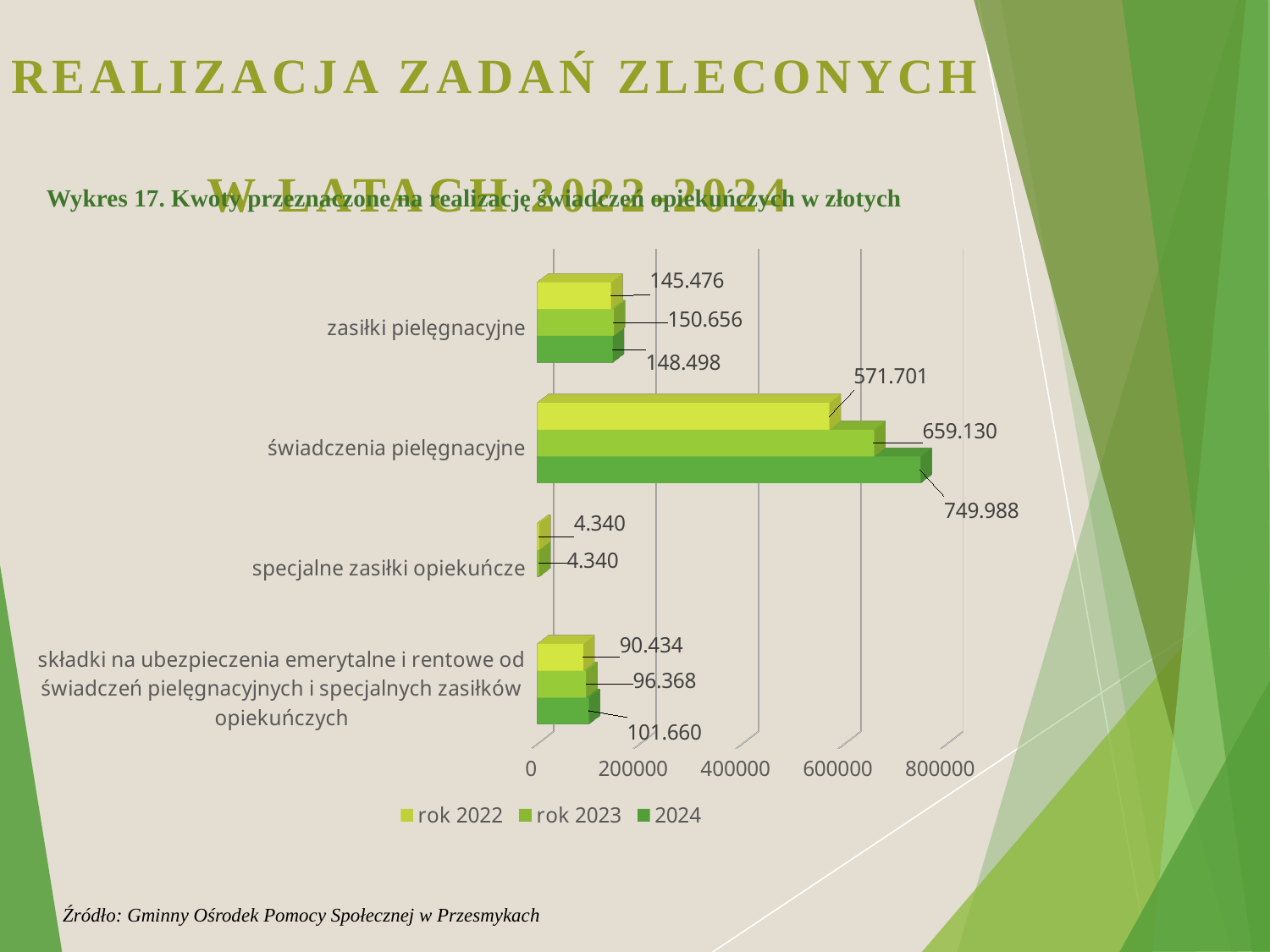
Which is larger for zasiłki pielęgnacyjne: the rok 2022 value or the rok 2023 value? rok 2023 Do the values for świadczenia pielęgnacyjne rise or fall from rok 2022 to 2024? rise How many categories are shown on the chart's vertical axis? 4 Which category has the highest value in the 2024 series? świadczenia pielęgnacyjne What kind of chart is shown on the slide? bar chart How many series does the chart legend list? 3 What is the title of the chart? Wykres 17. Kwoty przeznaczone na realizację świadczeń opiekuńczych w złotych What is the value for składki na ubezpieczenia emerytalne i rentowe od świadczeń pielęgnacyjnych i specjalnych zasiłków opiekuńczych in the rok 2022 series? 90.434 What is the difference between the 2024 and rok 2022 values for świadczenia pielęgnacyjne? 178.287 Which category has the lowest value in the rok 2022 series? specjalne zasiłki opiekuńcze What is the value for zasiłki pielęgnacyjne in the rok 2023 series? 150.656 What is the value for świadczenia pielęgnacyjne in the 2024 series? 749.988